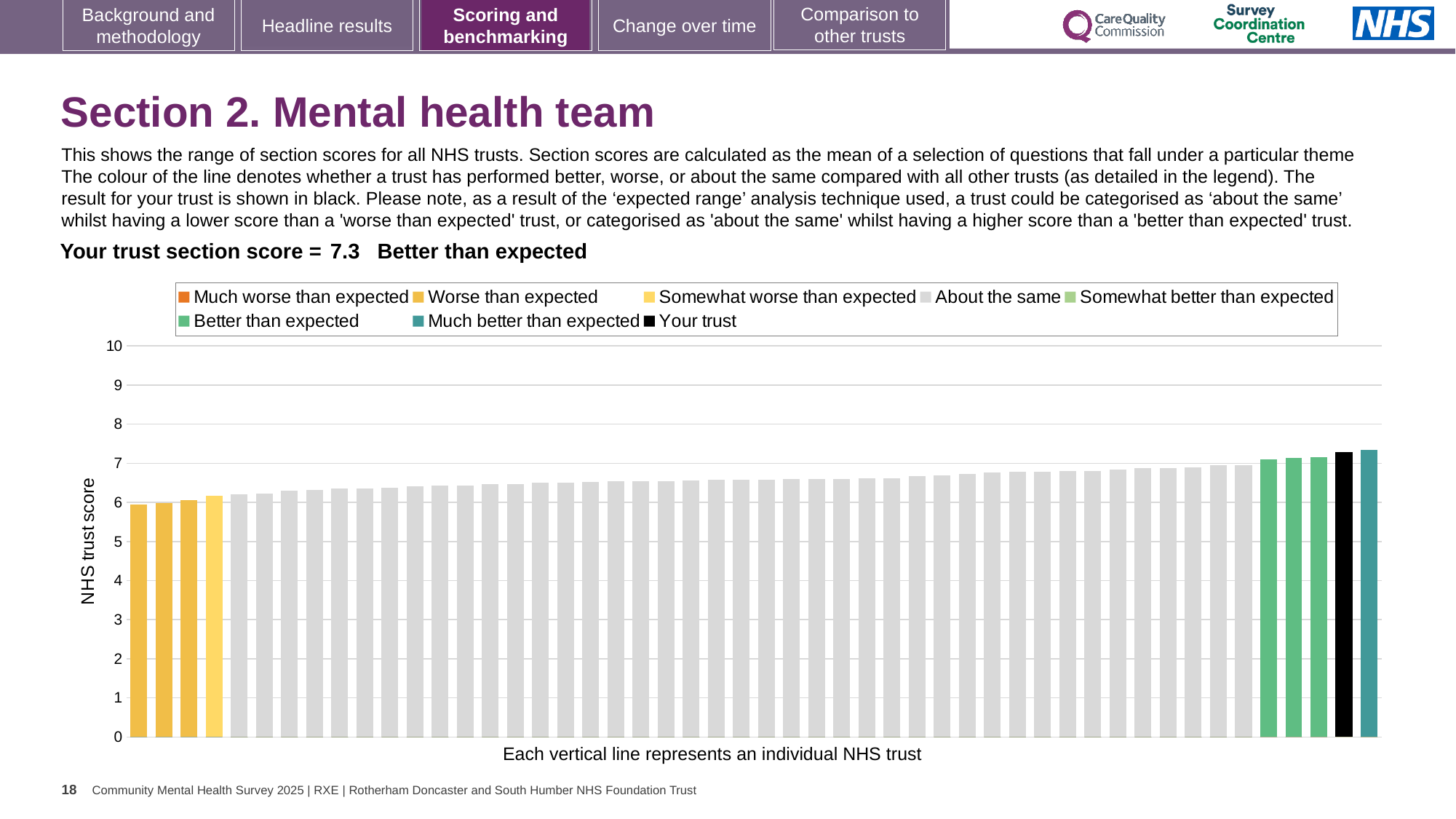
Do the bar values rise or fall from left to right along the x axis? rise Which legend category does the tallest bar belong to? Much better than expected Is the value of the tallest bar greater or less than 8? less How many bars are coloured as 'Much better than expected'? 1 How many bars are coloured as 'Worse than expected'? 3 How many entries does the chart legend list? 8 Is the value for your trust greater or less than 7? greater Is the value of the shortest bar greater or less than 5? greater What is the section score for your trust? 7.3 What kind of chart is shown on the slide? Bar chart What colour is the bar for your trust? Black Which performance category is your trust placed in for this section? Better than expected